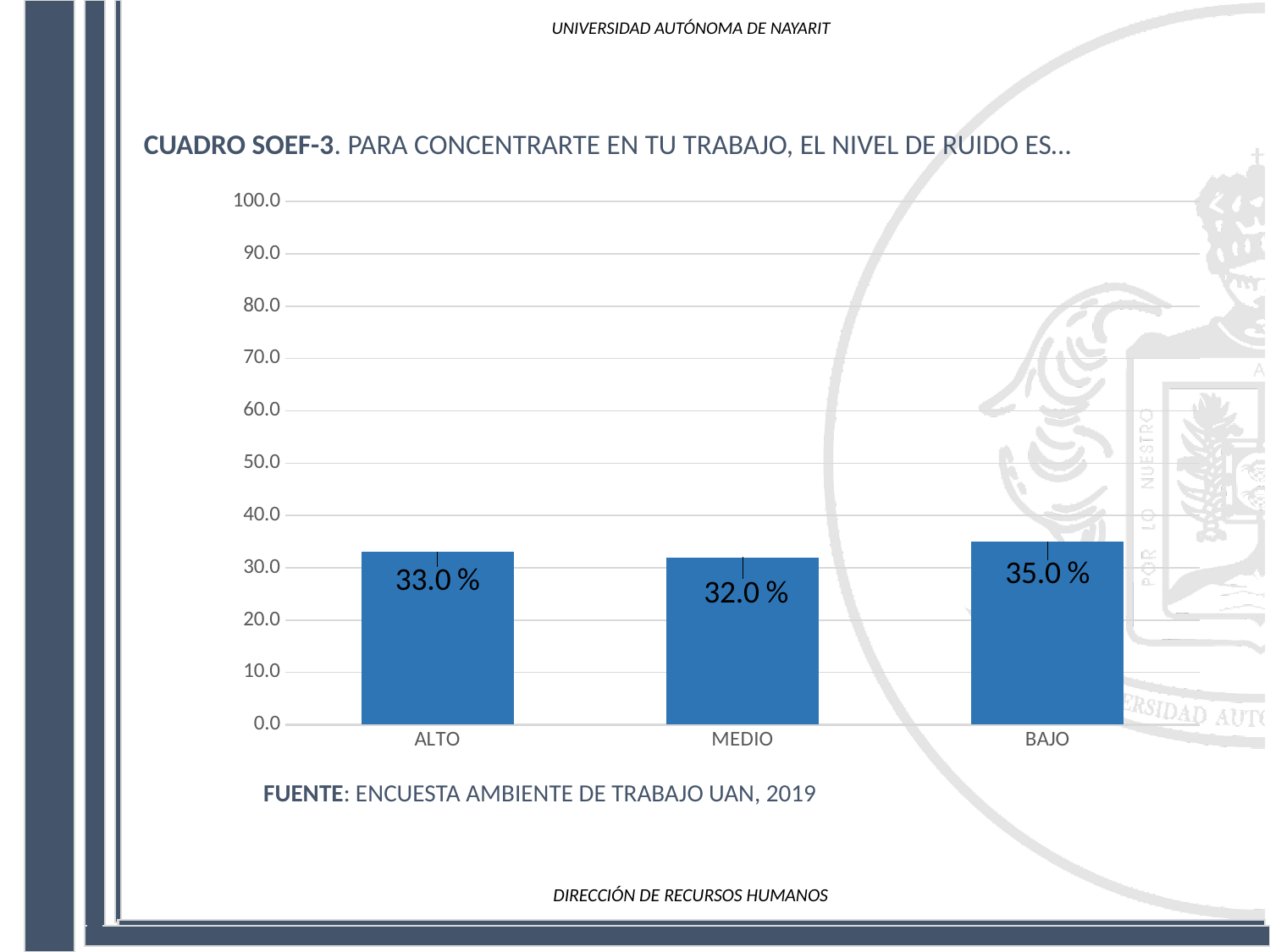
Which category has the lowest value? MEDIO What is the value for ALTO? 33.0 % Is the value for BAJO greater or less than 40.0? less What is the value for BAJO? 35.0 % What is the source cited below the chart? ENCUESTA AMBIENTE DE TRABAJO UAN, 2019 What kind of chart is shown on the slide? bar chart How many categories are shown on the x axis? 3 Which category has the highest value? BAJO Which is larger, the value for BAJO or the value for ALTO? BAJO What is the difference between the values for BAJO and MEDIO? 3.0 % What is the difference between the values for ALTO and MEDIO? 1.0 % What is the value for MEDIO? 32.0 %